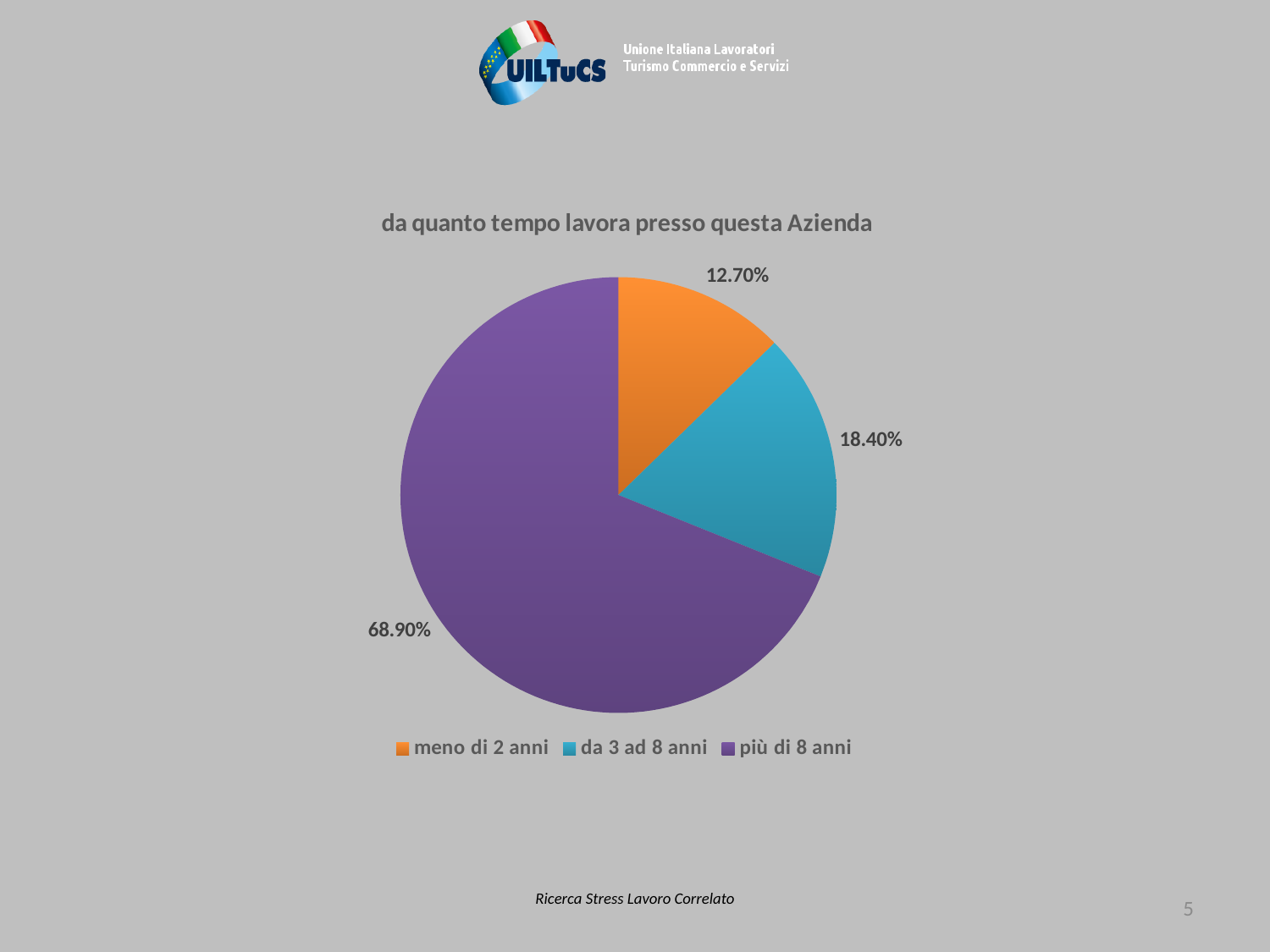
What percentage is shown for 'da 3 ad 8 anni'? 18.40% What colour is the slice for 'più di 8 anni'? purple What type of chart is shown on the slide? pie chart How many categories does the pie chart have? 3 Which is larger, the share for 'da 3 ad 8 anni' or for 'meno di 2 anni'? da 3 ad 8 anni Which category has the smallest share of the pie? meno di 2 anni Which category has the largest share of the pie? più di 8 anni What is the title of the chart? da quanto tempo lavora presso questa Azienda What percentage is shown for 'meno di 2 anni'? 12.70% What is the difference between the shares for 'più di 8 anni' and 'da 3 ad 8 anni'? 50.50% What percentage is shown for 'più di 8 anni'? 68.90% What is the difference between the shares for 'da 3 ad 8 anni' and 'meno di 2 anni'? 5.70%